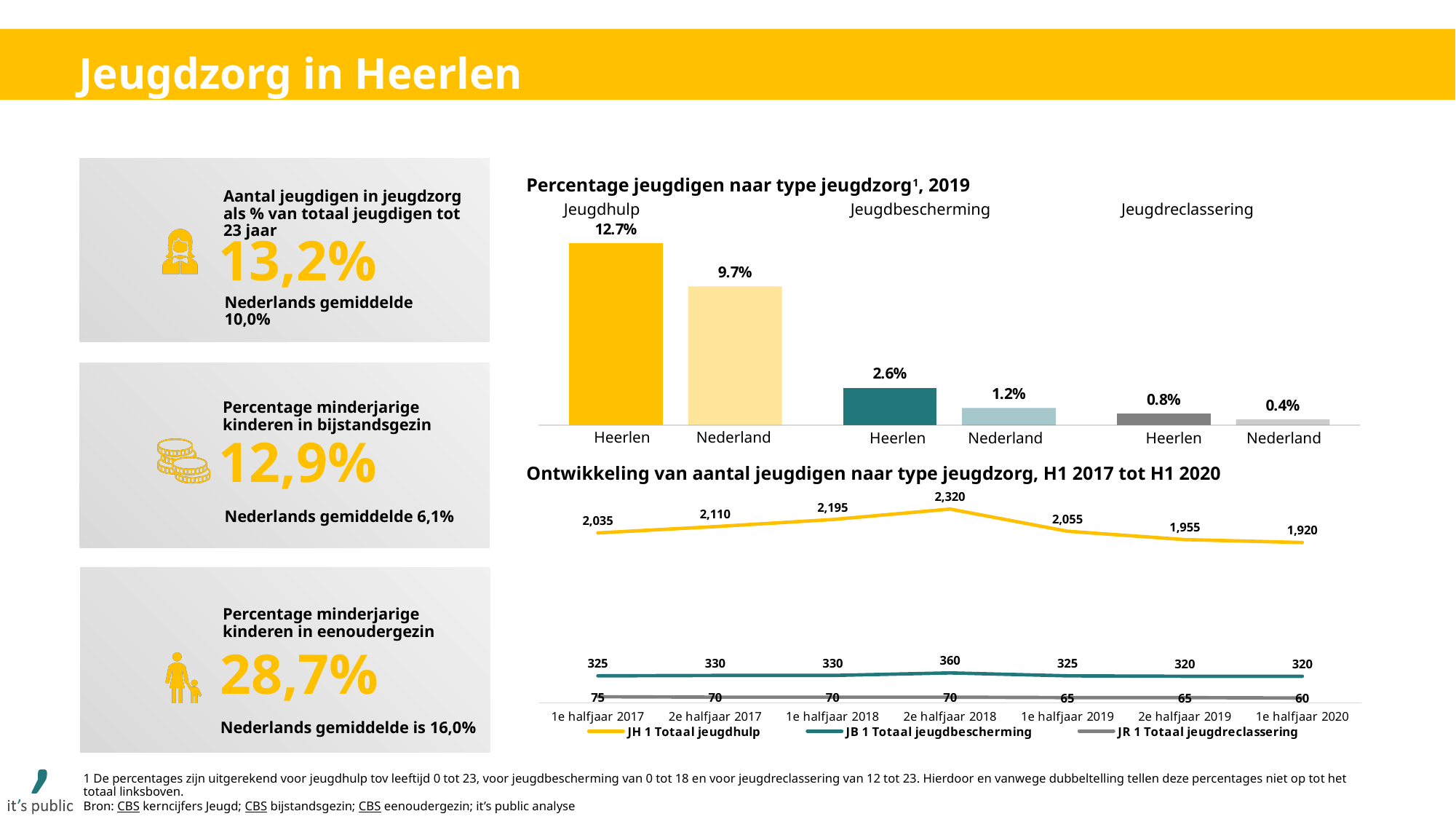
In the chart 'Percentage jeugdigen naar type jeugdzorg, 2019', what is the Jeugdbescherming percentage for Nederland? 1.2% In the chart 'Percentage jeugdigen naar type jeugdzorg, 2019', what is the Jeugdhulp percentage for Heerlen? 12.7% How many bars are shown in the chart 'Percentage jeugdigen naar type jeugdzorg, 2019'? 6 In the chart 'Percentage jeugdigen naar type jeugdzorg, 2019', which is larger: Jeugdreclassering for Heerlen or for Nederland? Heerlen In the chart 'Ontwikkeling van aantal jeugdigen naar type jeugdzorg', what is the difference in JH 1 Totaal jeugdhulp between 2e halfjaar 2018 and 1e halfjaar 2020? 400 In the chart 'Ontwikkeling van aantal jeugdigen naar type jeugdzorg', in which period does JB 1 Totaal jeugdbescherming reach its highest value? 2e halfjaar 2018 How many series does the legend of the chart 'Ontwikkeling van aantal jeugdigen naar type jeugdzorg' list? 3 In the chart 'Percentage jeugdigen naar type jeugdzorg, 2019', which bar has the lowest value? Jeugdreclassering Nederland In the chart 'Ontwikkeling van aantal jeugdigen naar type jeugdzorg', what is the value of JR 1 Totaal jeugdreclassering in 1e halfjaar 2020? 60 In the chart 'Ontwikkeling van aantal jeugdigen naar type jeugdzorg', what is the value of JH 1 Totaal jeugdhulp in 2e halfjaar 2018? 2,320 What type of chart is 'Ontwikkeling van aantal jeugdigen naar type jeugdzorg, H1 2017 tot H1 2020'? Line chart In the chart 'Percentage jeugdigen naar type jeugdzorg, 2019', what is the difference between the Jeugdhulp percentages for Heerlen and Nederland? 3.0%